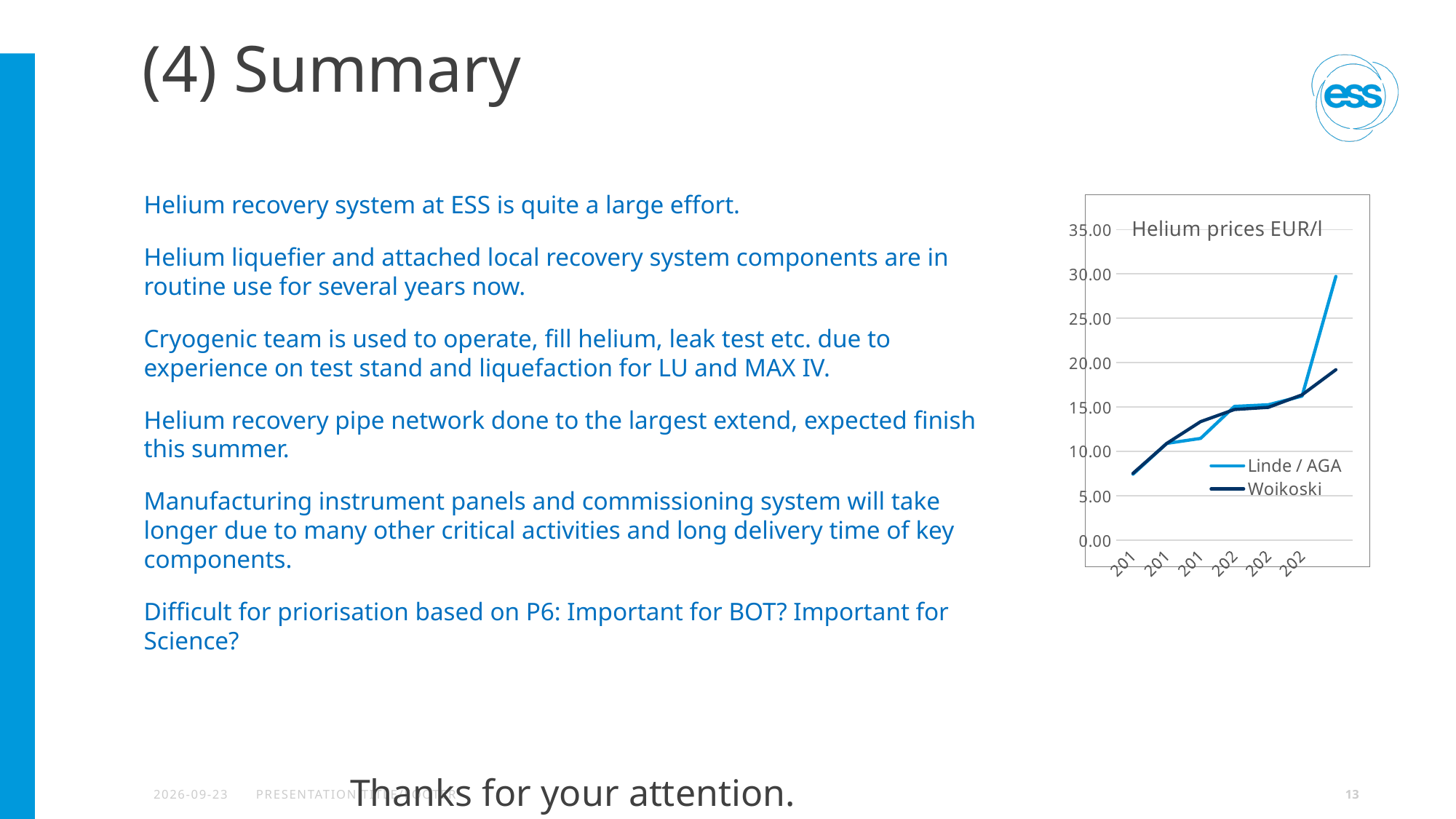
What kind of chart is shown on the slide? line chart Do the helium prices generally rise or fall along the x axis? rise What is the highest value shown on the chart's y axis? 35.00 What is the title of the chart? Helium prices EUR/l How many series does the chart's legend list? 2 Which series reaches the highest value on the chart? Linde / AGA Which two series are listed in the chart's legend? Linde / AGA and Woikoski Is the final value of the Woikoski series greater or less than 15.00? greater At the last point on the x axis, which series has the higher value, Linde / AGA or Woikoski? Linde / AGA Is the first value of the Woikoski series greater or less than 10.00? less Is the final value of the Linde / AGA series greater or less than 25.00? greater